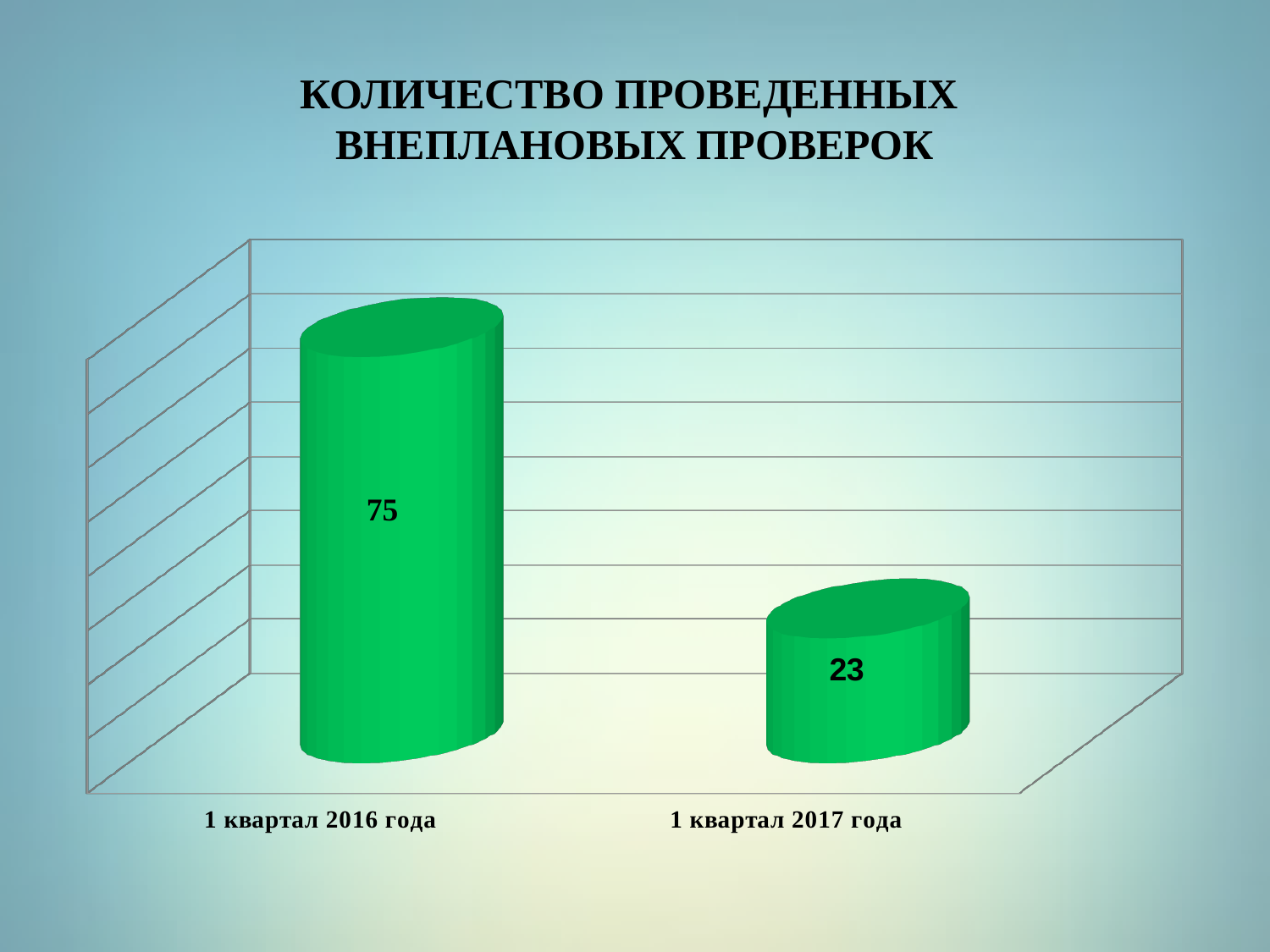
What is the value for 1 квартал 2017 года? 23 How many categories are shown in the chart? 2 What is the title of the chart? КОЛИЧЕСТВО ПРОВЕДЕННЫХ ВНЕПЛАНОВЫХ ПРОВЕРОК What is the value for 1 квартал 2016 года? 75 Do the values rise or fall from 1 квартал 2016 года to 1 квартал 2017 года? fall What is the difference between the values for 1 квартал 2016 года and 1 квартал 2017 года? 52 What colour are the bars in the chart? green Which category has the highest value? 1 квартал 2016 года What kind of chart is shown on the slide? bar chart Which is larger: the value for 1 квартал 2016 года or for 1 квартал 2017 года? 1 квартал 2016 года Which category has the lowest value? 1 квартал 2017 года